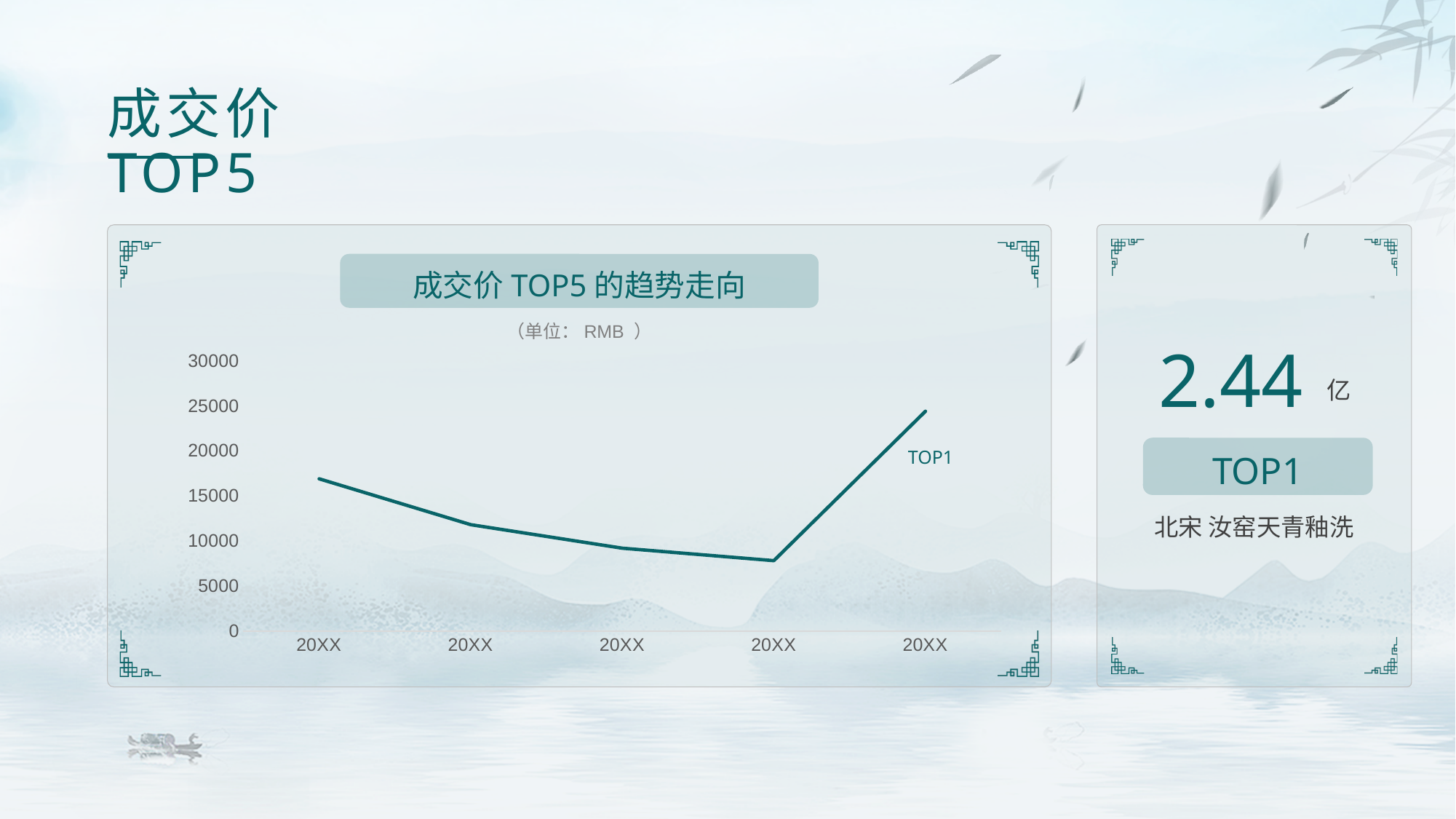
Is the value of the fourth point greater or less than 10000? less How does the line move from left to right across the x axis? it falls over the first four points, then rises sharply to the last point Is the value of the last point greater or less than 20000? greater Is the value of the second point greater or less than 10000? greater What unit is stated below the chart title? RMB Which point on the line has the lowest value? the fourth point How many data points are plotted on the line chart? 5 What kind of chart is shown on the slide? line chart Which is larger, the value of the first point or the value of the last point? the last point Which point on the line has the highest value? the last (fifth) point What is the title of the chart? 成交价 TOP5 的趋势走向